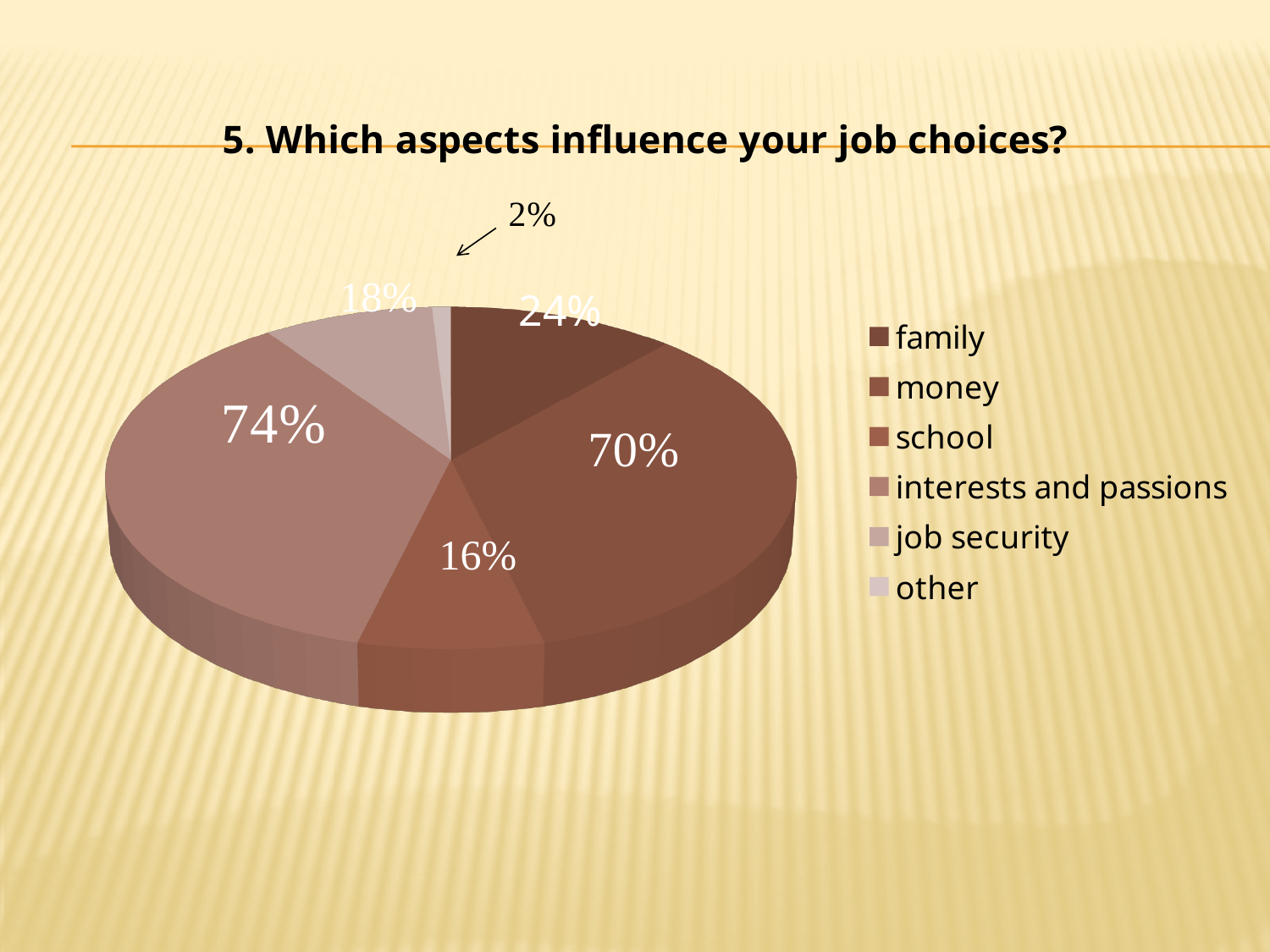
What is the value shown for job security? 18% What is the value shown for family? 24% How many categories does the pie chart show? 6 What is the title of the chart? 5. Which aspects influence your job choices? What is the value shown for money? 70% What is the value shown for interests and passions? 74% What type of chart is shown on the slide? pie chart Which category has the smallest value? other What is the value shown for school? 16% What is the difference between the values for money and school? 54% Which is larger, the value for family or the value for school? family Which category has the largest value? interests and passions